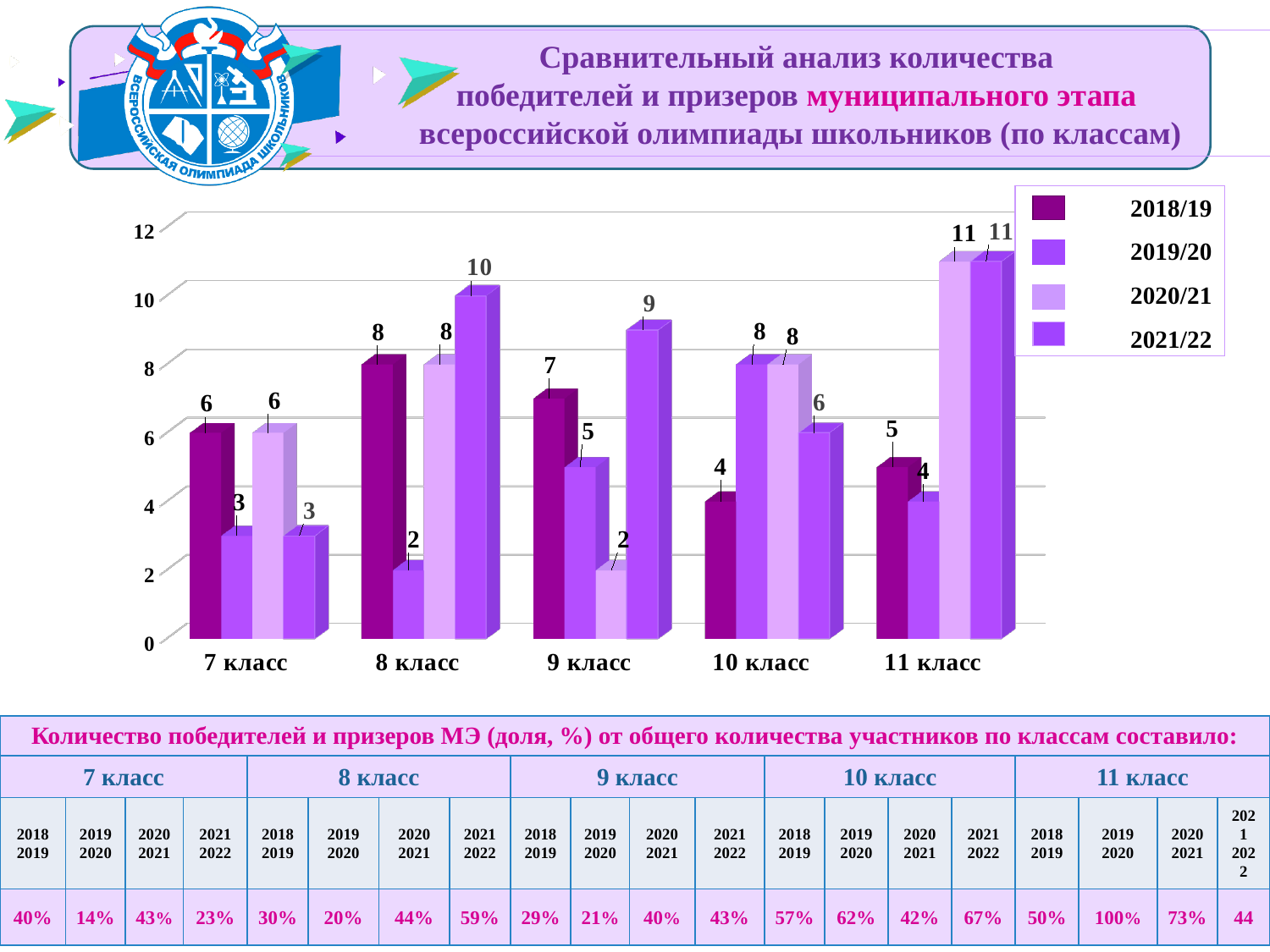
Which is larger for 10 класс: the 2018/19 value or the 2021/22 value? 2021/22 Which class has the highest value in the 2020/21 series? 11 класс Which series is shown in the darkest purple colour in the legend? 2018/19 Which class has the lowest value in the 2019/20 series? 8 класс What is the value for 8 класс in the 2021/22 series? 10 How many class categories are shown on the x axis of the chart? 5 Is the value for 11 класс in the 2021/22 series greater or less than 10? greater What is the value for 9 класс in the 2020/21 series? 2 What is the difference between the 2021/22 and 2019/20 values for 9 класс? 4 How many series does the chart legend list? 4 What type of chart is shown on the slide? bar chart What is the value for 11 класс in the 2018/19 series? 5